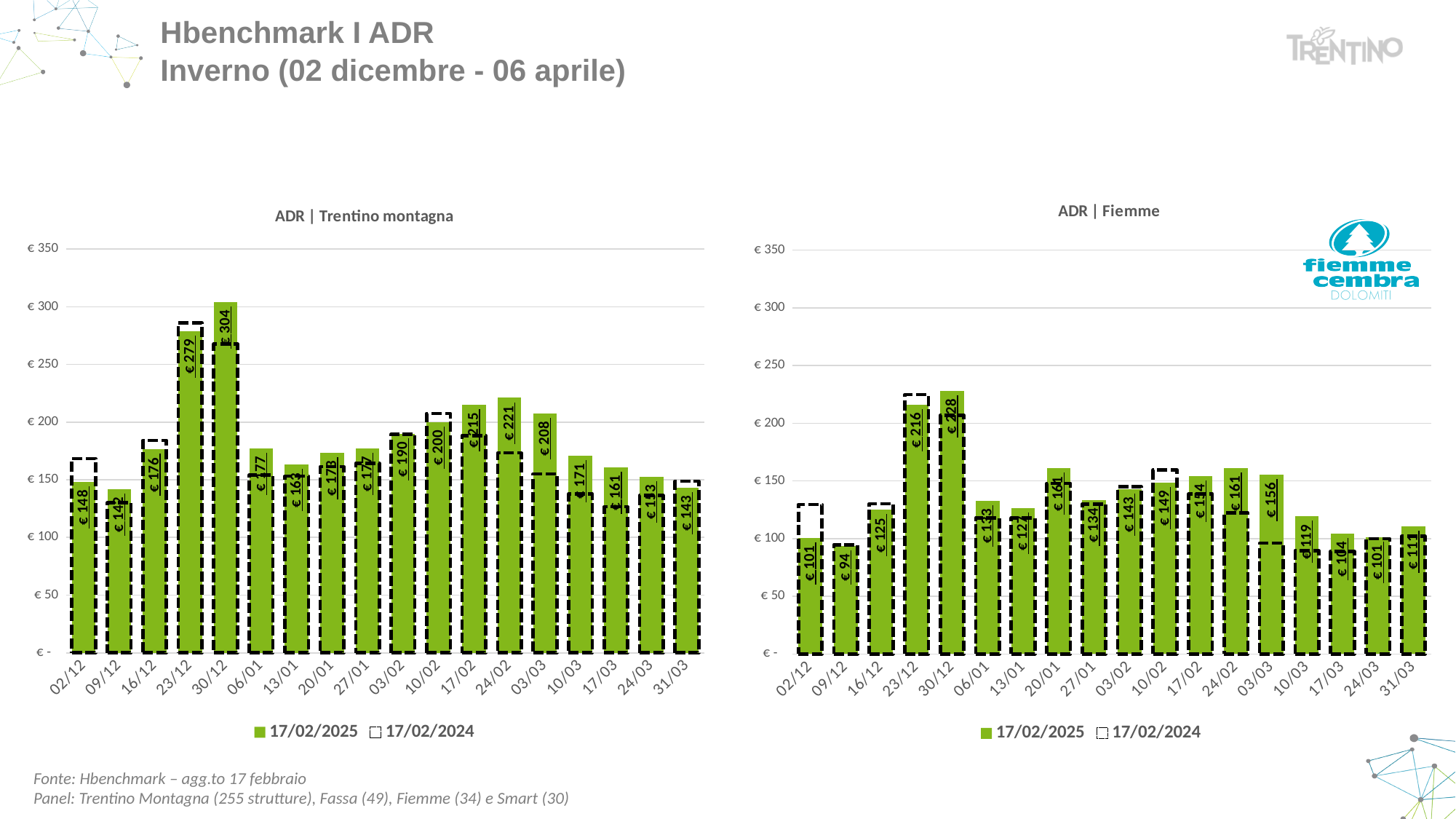
In the ADR | Trentino montagna chart, which date has the highest 17/02/2025 value? 30/12 In the ADR | Fiemme chart, what is the 17/02/2025 value for 23/12? € 216 In the ADR | Fiemme chart, which date has the lowest 17/02/2025 value? 09/12 In the ADR | Fiemme chart, which has the larger 17/02/2025 value, 03/03 or 10/03? 03/03 In the ADR | Fiemme chart, what is the 17/02/2025 value for 09/12? € 94 How many dates are shown on the x axis of the ADR | Fiemme chart? 18 In the ADR | Trentino montagna chart, what is the 17/02/2025 value for 30/12? € 304 In the ADR | Trentino montagna chart, what is the difference between the 17/02/2025 values for 24/02 and 17/02? € 6 How many series does the legend of the ADR | Trentino montagna chart list? 2 What kind of chart is the ADR | Fiemme chart? Bar chart In the ADR | Trentino montagna chart, what is the 17/02/2025 value for 24/02? € 221 In the ADR | Fiemme chart, is the 17/02/2024 value for 02/12 greater or less than € 100? greater